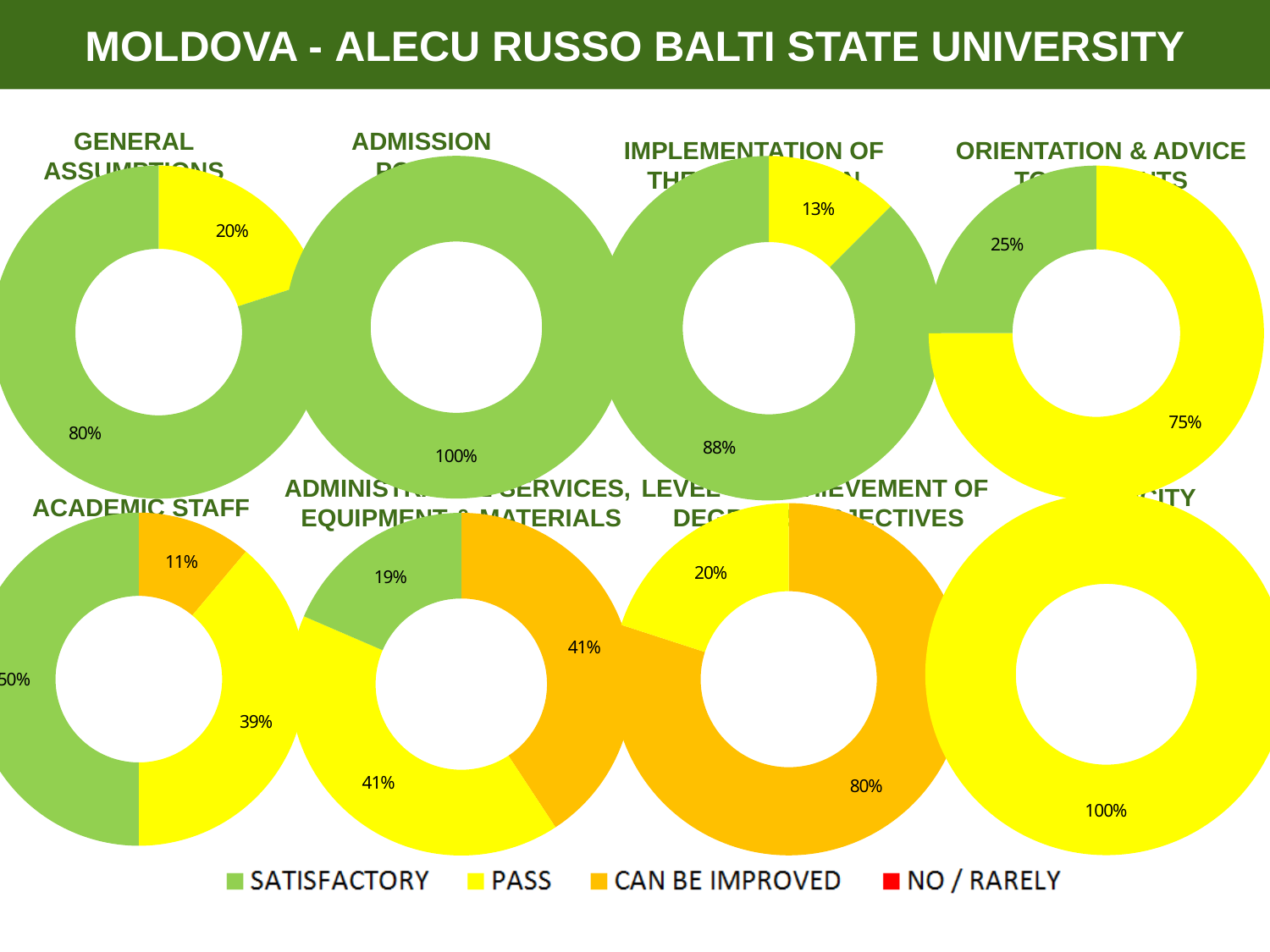
In the ADMINISTRATIVE SERVICES, EQUIPMENT & MATERIALS chart, what share is SATISFACTORY? 19% In the ADMISSION chart (top row, second from left), what share is SATISFACTORY? 100% In the bottom-right chart, what share is PASS? 100% How many series does the legend list? 4 In the ACADEMIC STAFF chart, which category has the largest share? SATISFACTORY In the LEVEL OF ACHIEVEMENT chart (bottom row, third from left), what is the difference between the CAN BE IMPROVED share and the PASS share? 60% What kind of charts are shown on the slide? Doughnut (pie) charts